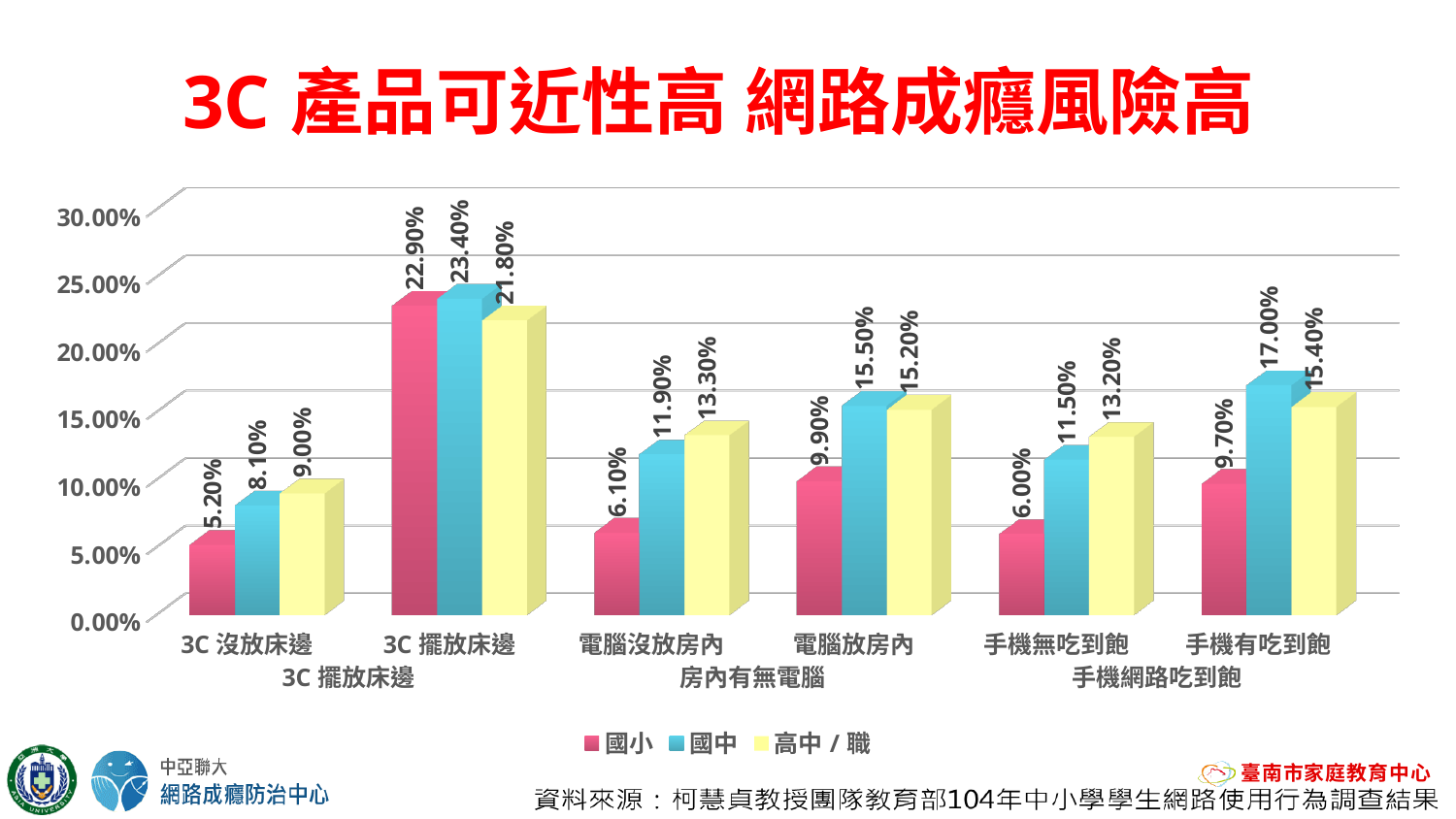
Which is larger in the 電腦放房內 category: the 國中 value or the 高中／職 value? 國中 Which category has the lowest value for the 國中 series? 3C 沒放床邊 Is the value for 國小 in the 3C 擺放床邊 category greater or less than 20.00%? greater What is the value for 國小 in the 手機有吃到飽 category? 9.70% Which category has the highest value for the 國小 series? 3C 擺放床邊 Which colour represents the 高中／職 series in the legend? yellow What is the value for 國中 in the 3C 擺放床邊 category? 23.40% What is the difference between the 國中 and 國小 values in the 手機有吃到飽 category? 7.30% How many series does the legend list? 3 How many categories are shown on the x axis? 6 What is the value for 高中／職 in the 電腦沒放房內 category? 13.30% What kind of chart is shown on the slide? bar chart